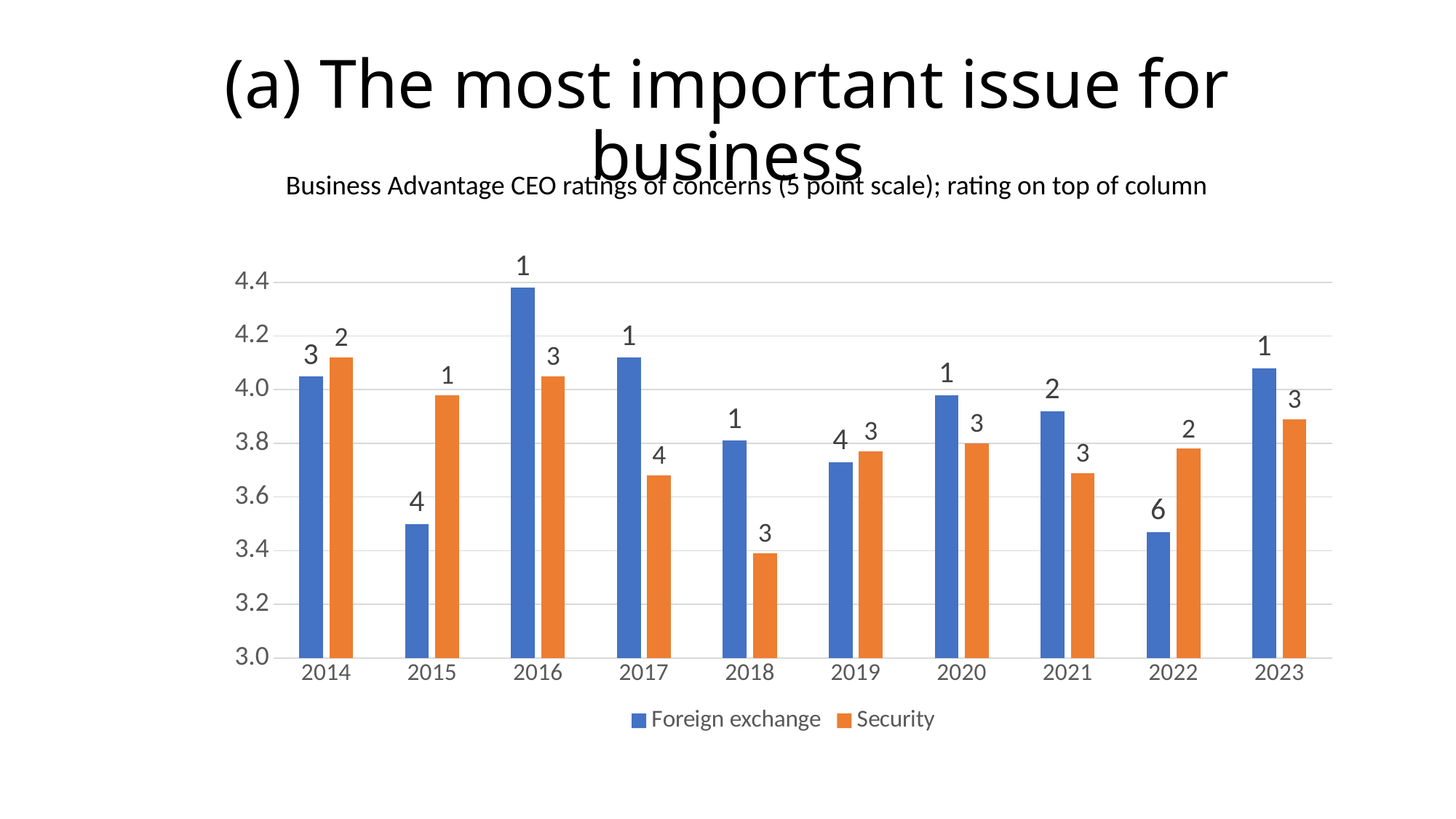
What number is printed above the Foreign exchange bar for 2022? 6 How many series does the legend list? 2 In 2017, which is larger, the Foreign exchange bar or the Security bar? Foreign exchange In 2022, which is larger, the Foreign exchange bar or the Security bar? Security What kind of chart is shown on the slide? bar chart How many years are shown on the x axis? 10 Which year has the lowest Security bar? 2018 Which colour represents the Security series? orange Is the Foreign exchange value for 2016 greater or less than 4.2? greater Is the Foreign exchange value for 2022 greater or less than 3.6? less Is the Security value for 2018 greater or less than 3.6? less Which year has the highest Foreign exchange bar? 2016